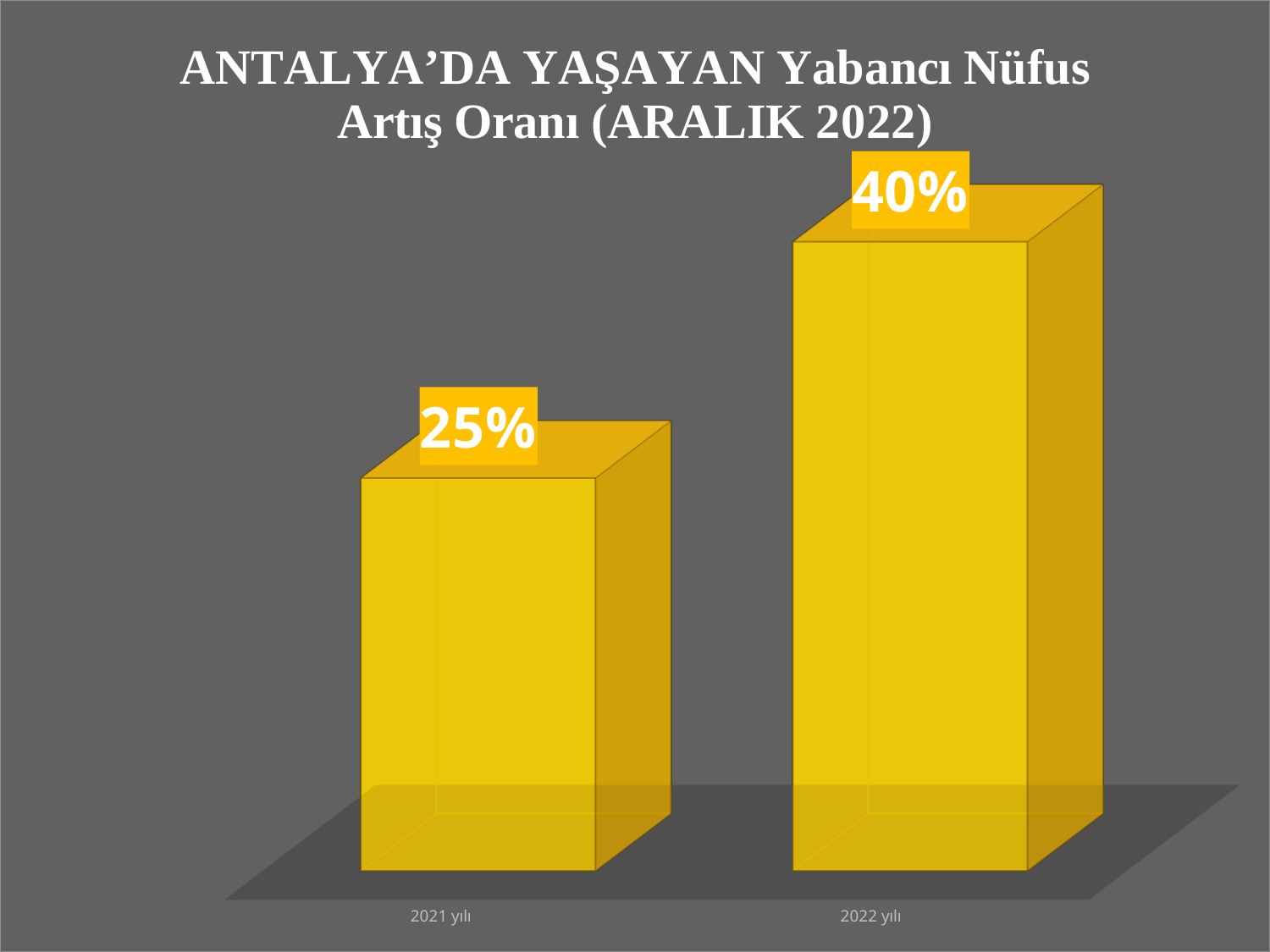
What is the value for 2021 yılı? 25% Do the values rise or fall from 2021 yılı to 2022 yılı? rise What is the title of the chart? ANTALYA'DA YAŞAYAN Yabancı Nüfus Artış Oranı (ARALIK 2022) What is the difference between the values for 2022 yılı and 2021 yılı? 15% Which is larger, the value for 2021 yılı or the value for 2022 yılı? 2022 yılı What colour are the bars in the chart? yellow What is the value for 2022 yılı? 40% Which category has the highest value? 2022 yılı What kind of chart is shown on the slide? bar chart How many categories are shown in the chart? 2 Which category has the lowest value? 2021 yılı